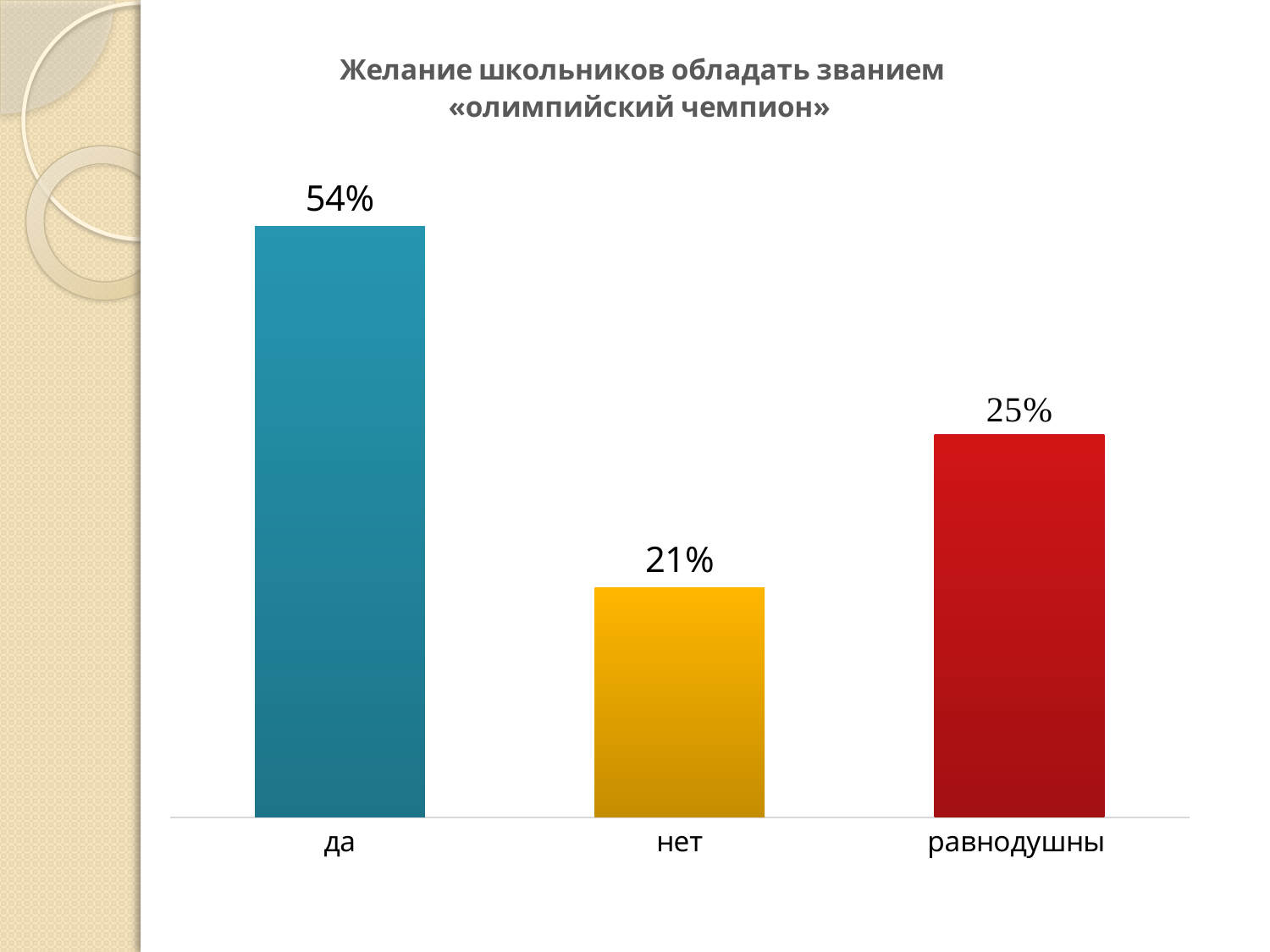
What is the value for "равнодушны"? 25% What is the value for "нет"? 21% Which is larger, the value for "да" or the value for "равнодушны"? да What kind of chart is shown on the slide? bar chart What is the title of the chart? Желание школьников обладать званием «олимпийский чемпион» Which category has the highest value? да What colour is the bar for "нет"? yellow How many categories are shown in the chart? 3 What is the difference between the values for "равнодушны" and "нет"? 4% Which category has the lowest value? нет What is the value for "да"? 54% What is the difference between the values for "да" and "нет"? 33%